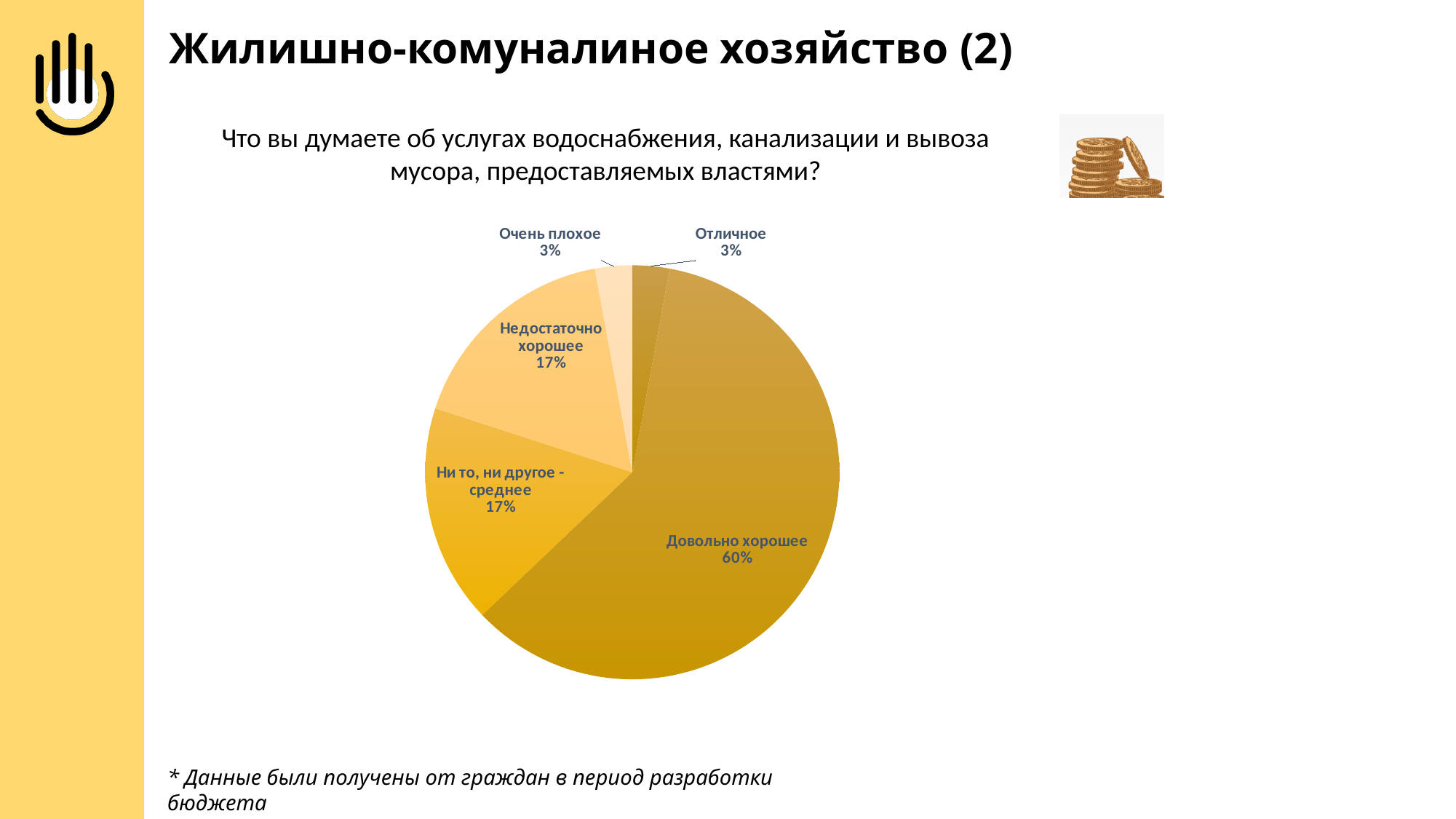
Which is larger: the share for "Довольно хорошее" or the share for "Недостаточно хорошее"? Довольно хорошее Which response category has the largest share of the pie? Довольно хорошее What is the combined share of "Отличное" and "Довольно хорошее"? 63% What share of respondents answered "Очень плохое"? 3% What question is the pie chart answering, according to the text above it? Что вы думаете об услугах водоснабжения, канализации и вывоза мусора, предоставляемых властями? What type of chart is shown on the slide? pie chart How many slices does the pie chart have? 5 What is the difference in percentage points between "Довольно хорошее" and "Ни то, ни другое - среднее"? 43% What share of respondents answered "Довольно хорошее"? 60% What share of respondents answered "Ни то, ни другое - среднее"? 17% What share of respondents answered "Недостаточно хорошее"? 17% What share of respondents answered "Отличное"? 3%